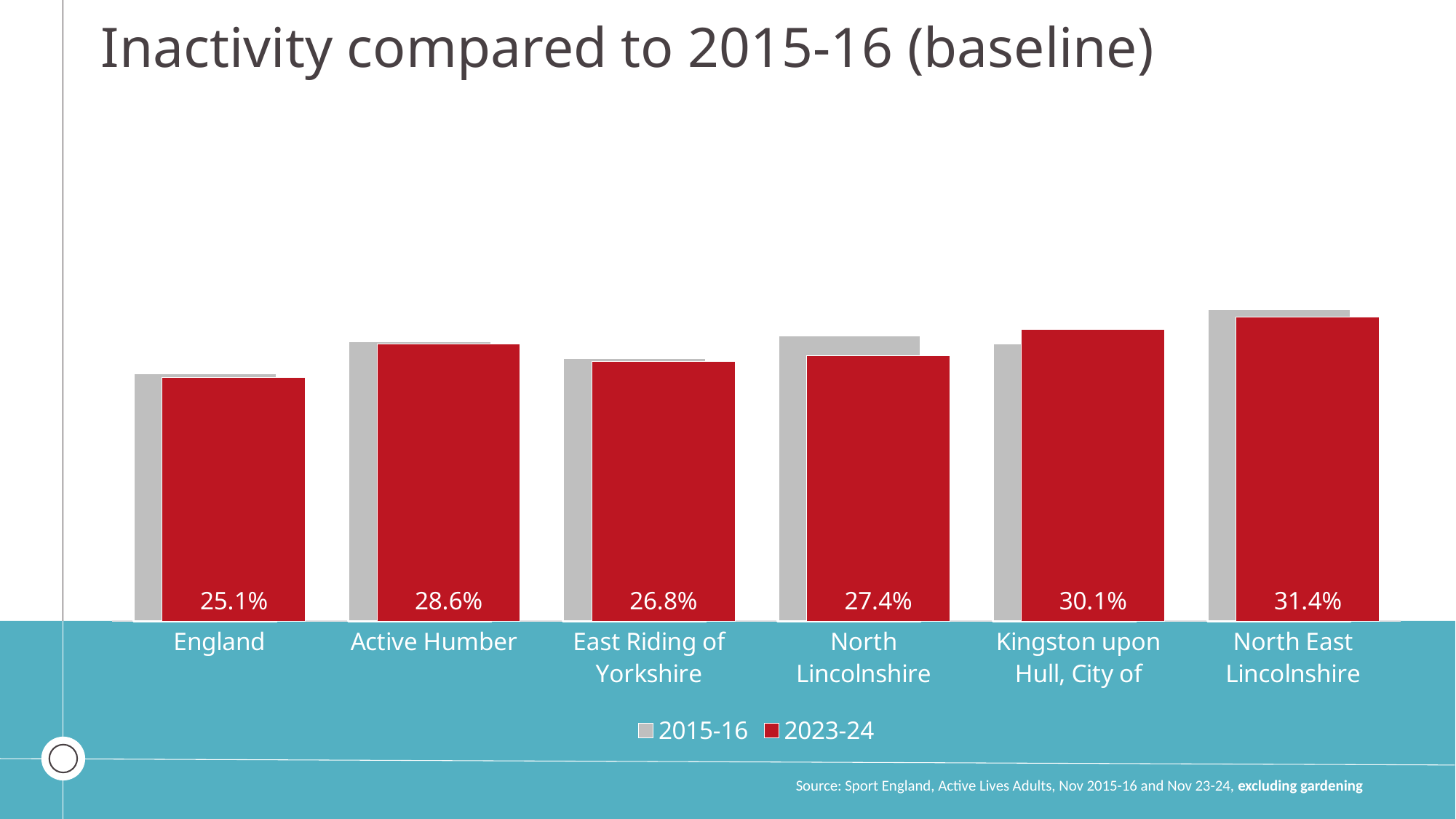
Which has the larger 2023-24 value, East Riding of Yorkshire or North Lincolnshire? North Lincolnshire What is the difference between the 2023-24 values for North East Lincolnshire and England? 6.3% What is the 2023-24 inactivity value for England? 25.1% What type of chart is shown on the slide? bar chart How many series does the legend list? 2 Which area has the highest 2023-24 inactivity value? North East Lincolnshire What is the 2023-24 inactivity value for North Lincolnshire? 27.4% What is the 2023-24 inactivity value for Kingston upon Hull, City of? 30.1% What is the 2023-24 inactivity value for Active Humber? 28.6% Which category has the lowest 2023-24 inactivity value? England How many categories are shown on the x axis? 6 For Kingston upon Hull, City of, is the 2015-16 bar taller or shorter than the 2023-24 bar? shorter